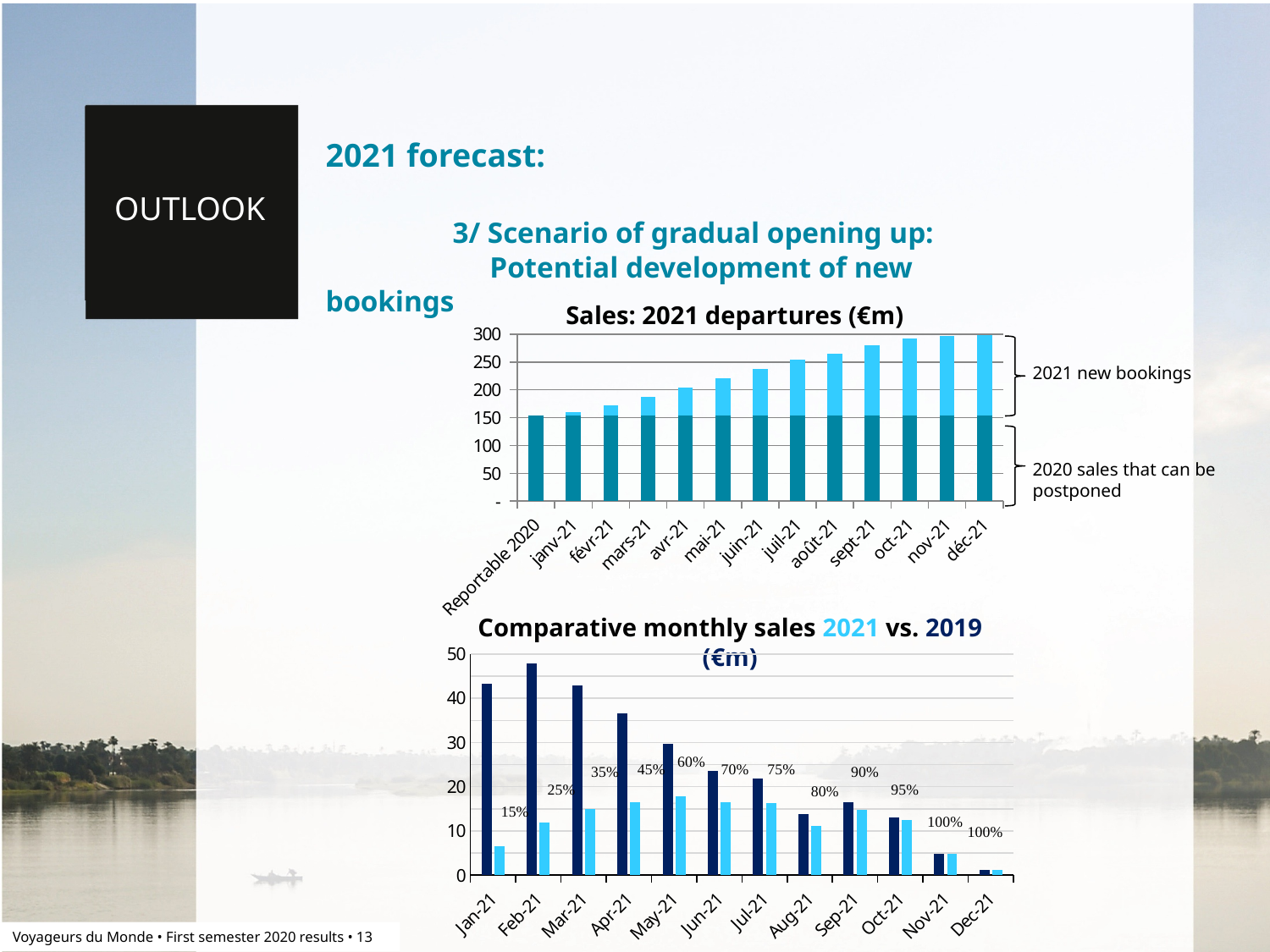
In the 'Sales: 2021 departures (€m)' chart, is the total value for déc-21 greater or less than 250? greater In the 'Sales: 2021 departures (€m)' chart, how many series are stacked in each bar? 2 What kind of chart is the 'Sales: 2021 departures (€m)' chart? Stacked bar chart In the 'Comparative monthly sales 2021 vs. 2019 (€m)' chart, what percentage label is shown for May-21? 60% In the 'Sales: 2021 departures (€m)' chart, do the total bar values rise or fall from left to right along the x axis? Rise In the 'Comparative monthly sales 2021 vs. 2019 (€m)' chart, which month has the highest 2019 bar? Feb-21 In the 'Sales: 2021 departures (€m)' chart, is the total value for Reportable 2020 greater or less than 200? less In the 'Comparative monthly sales 2021 vs. 2019 (€m)' chart, what percentage label is shown for Jan-21? 15% In the 'Sales: 2021 departures (€m)' chart, how many categories are shown on the x axis? 13 In the 'Sales: 2021 departures (€m)' chart, which category has the highest total bar? déc-21 In the 'Comparative monthly sales 2021 vs. 2019 (€m)' chart, is the 2019 value for Jan-21 greater or less than 40? greater In the 'Comparative monthly sales 2021 vs. 2019 (€m)' chart, how many months are shown on the x axis? 12